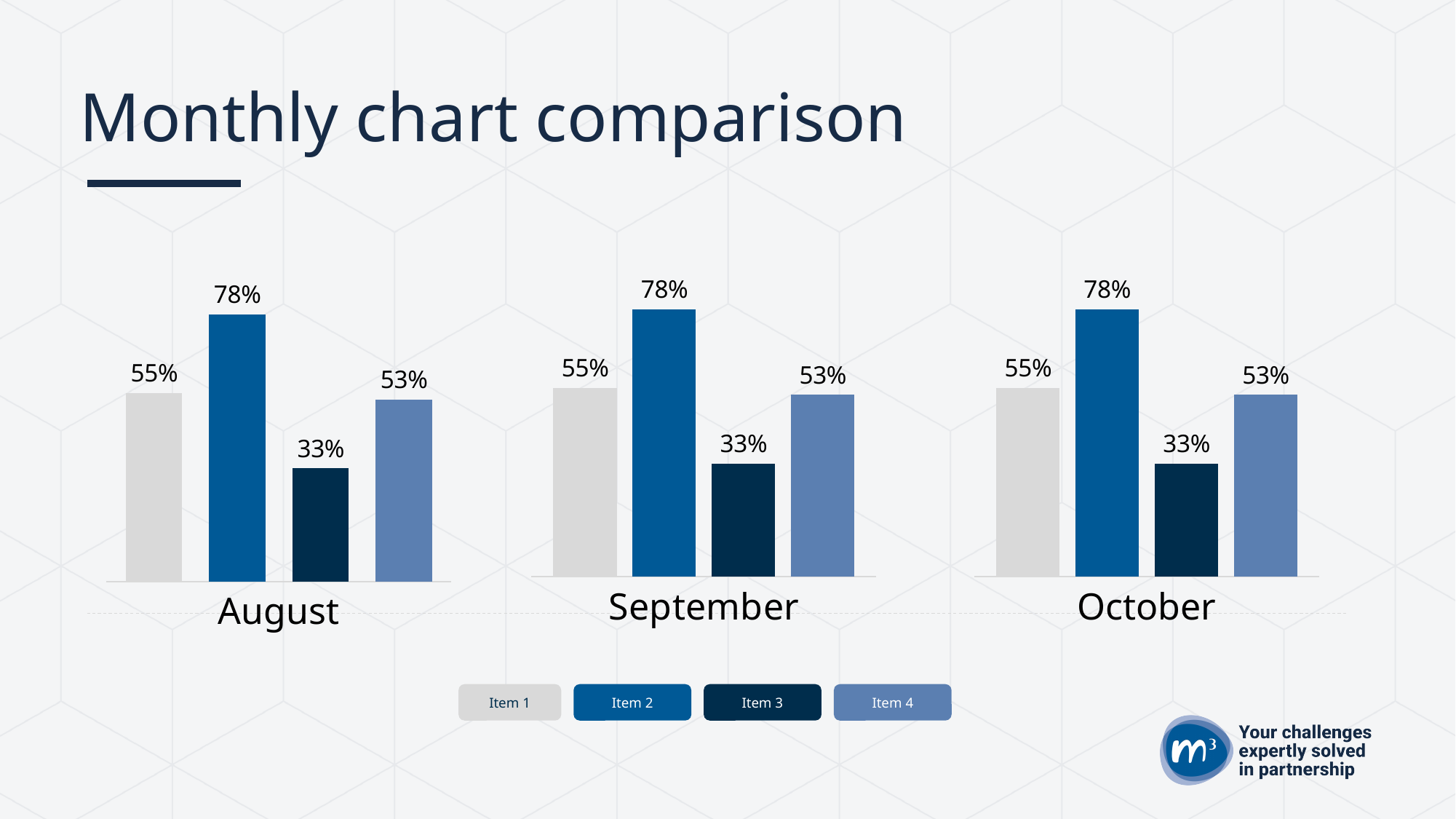
In the October chart, which is larger, the value for Item 1 or the value for Item 3? Item 1 In the October chart, what is the value for Item 4? 53% What kind of chart is the August chart? Bar chart How many bars are shown in the September chart? 4 In the August chart, what is the difference between the values for Item 1 and Item 4? 2% In the September chart, what is the value for Item 3? 33% How many series does the legend list? 4 What is the title of the slide? Monthly chart comparison In the August chart, what is the value for Item 2? 78% In the October chart, which item has the lowest value? Item 3 In the September chart, what is the difference between the values for Item 2 and Item 3? 45% In the August chart, which item has the highest value? Item 2